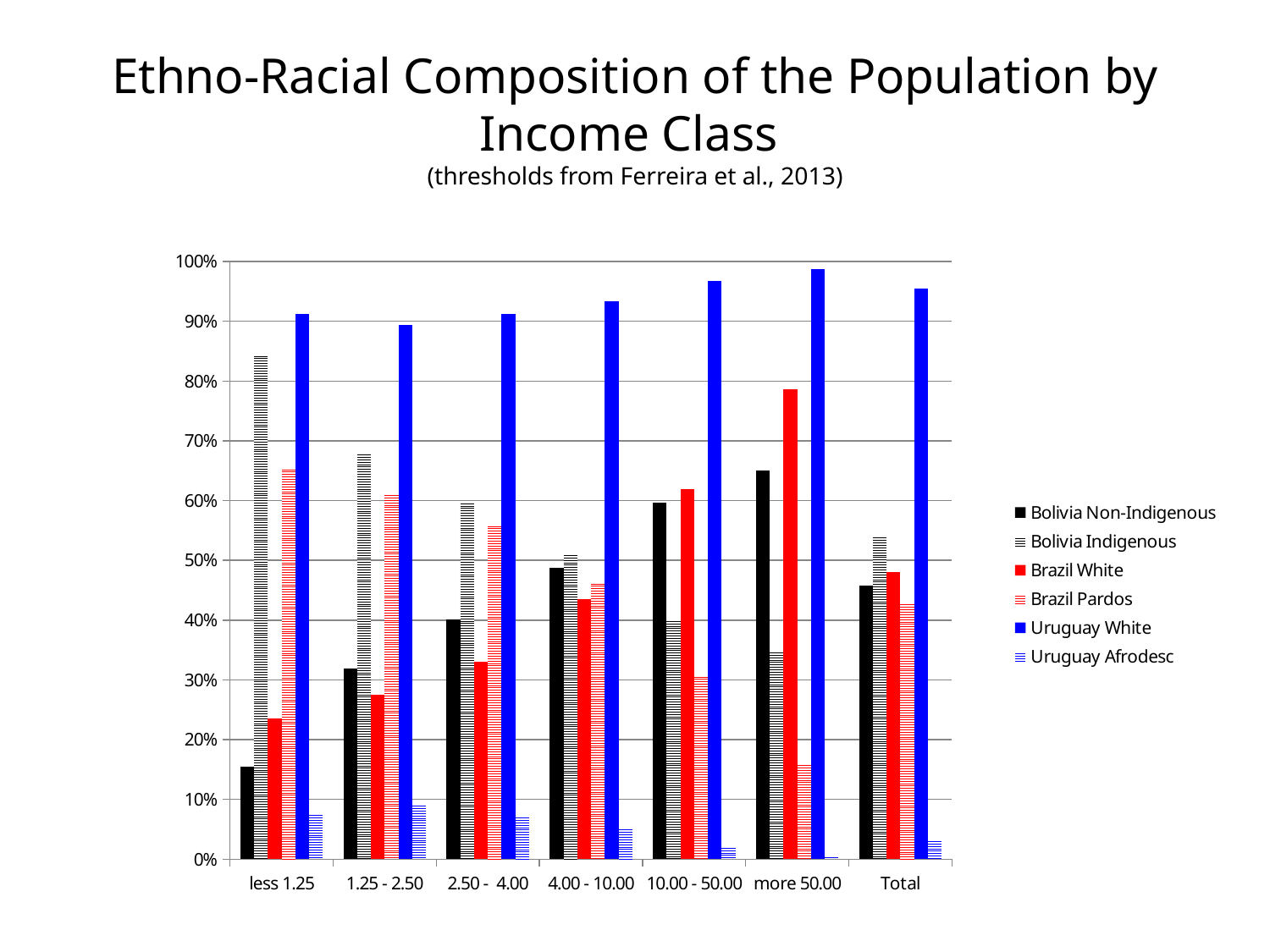
Does the Bolivia Indigenous share rise or fall as income class increases from 'less 1.25' to 'more 50.00'? fall How many series does the legend list? 6 Which series has the highest value in the 'less 1.25' income class? Uruguay White Which series has the lowest value in the 'more 50.00' income class? Uruguay Afrodesc In the 'more 50.00' income class, which is larger: Brazil White or Brazil Pardos? Brazil White Is the value for Brazil White in the 'more 50.00' income class greater or less than 70%? greater Is the value for Bolivia Indigenous in the 'less 1.25' income class greater or less than 80%? greater Is the value for Uruguay White in the 'more 50.00' income class greater or less than 90%? greater What kind of chart is shown on the slide? bar chart Which series is shown with solid blue bars? Uruguay White How many income class categories are shown on the x axis? 7